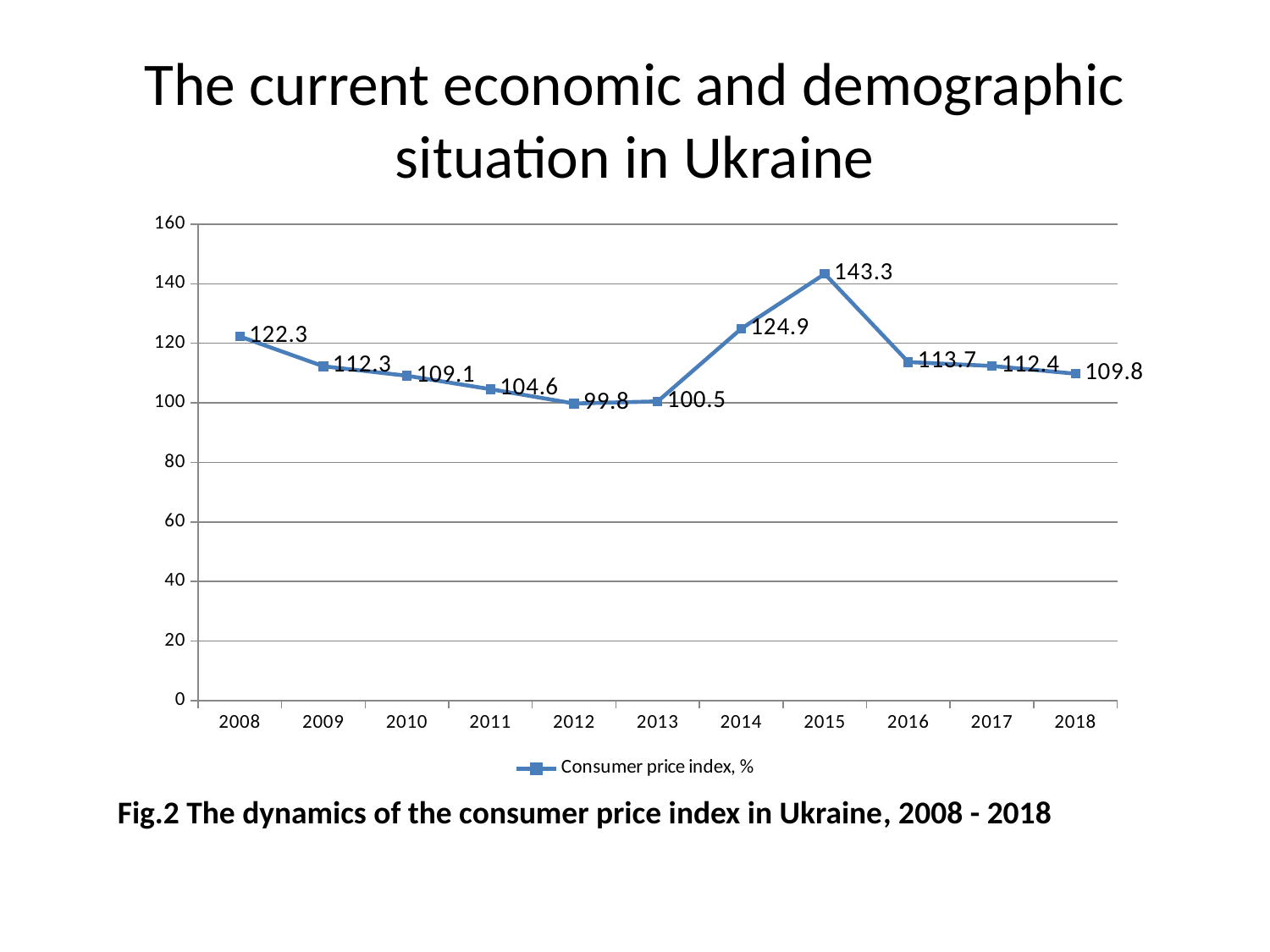
What is the consumer price index value for 2015? 143.3 What is the consumer price index value for 2008? 122.3 Does the consumer price index rise or fall from 2008 to 2012? fall Which year has the highest consumer price index? 2015 Which year has a higher consumer price index, 2009 or 2016? 2016 Which year has the lowest consumer price index? 2012 What is the difference between the consumer price index in 2015 and in 2014? 18.4 What is the consumer price index value for 2012? 99.8 Is the consumer price index for 2018 greater or less than 100? greater How many series does the legend list? 1 How many years are plotted on the chart? 11 What kind of chart is shown on the slide? line chart